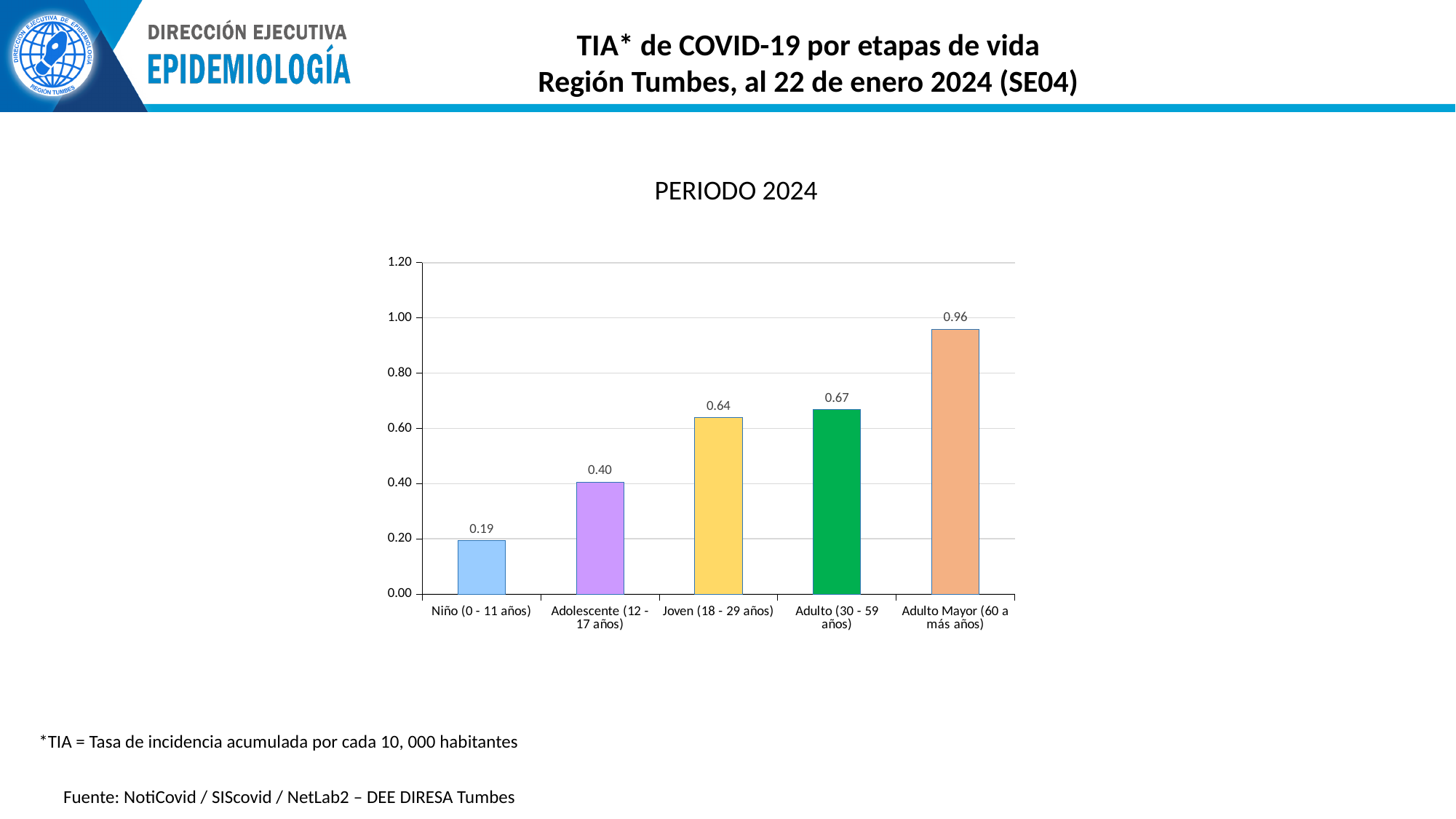
Which has a larger TIA value, Adolescente (12 - 17 años) or Joven (18 - 29 años)? Joven (18 - 29 años) What is the TIA value for Adolescente (12 - 17 años)? 0.40 Which life stage has the highest TIA value? Adulto Mayor (60 a más años) What kind of chart is shown on the slide? Bar chart Do the TIA values rise or fall from left to right across the life stages? Rise What is the TIA value for Joven (18 - 29 años)? 0.64 What is the TIA value for Niño (0 - 11 años)? 0.19 What is the difference between the TIA values for Adulto Mayor (60 a más años) and Niño (0 - 11 años)? 0.77 Which life stage has the lowest TIA value? Niño (0 - 11 años) How many life-stage categories are shown in the chart? 5 What is the TIA value for Adulto Mayor (60 a más años)? 0.96 Is the value for Adulto (30 - 59 años) greater or less than 0.60? greater